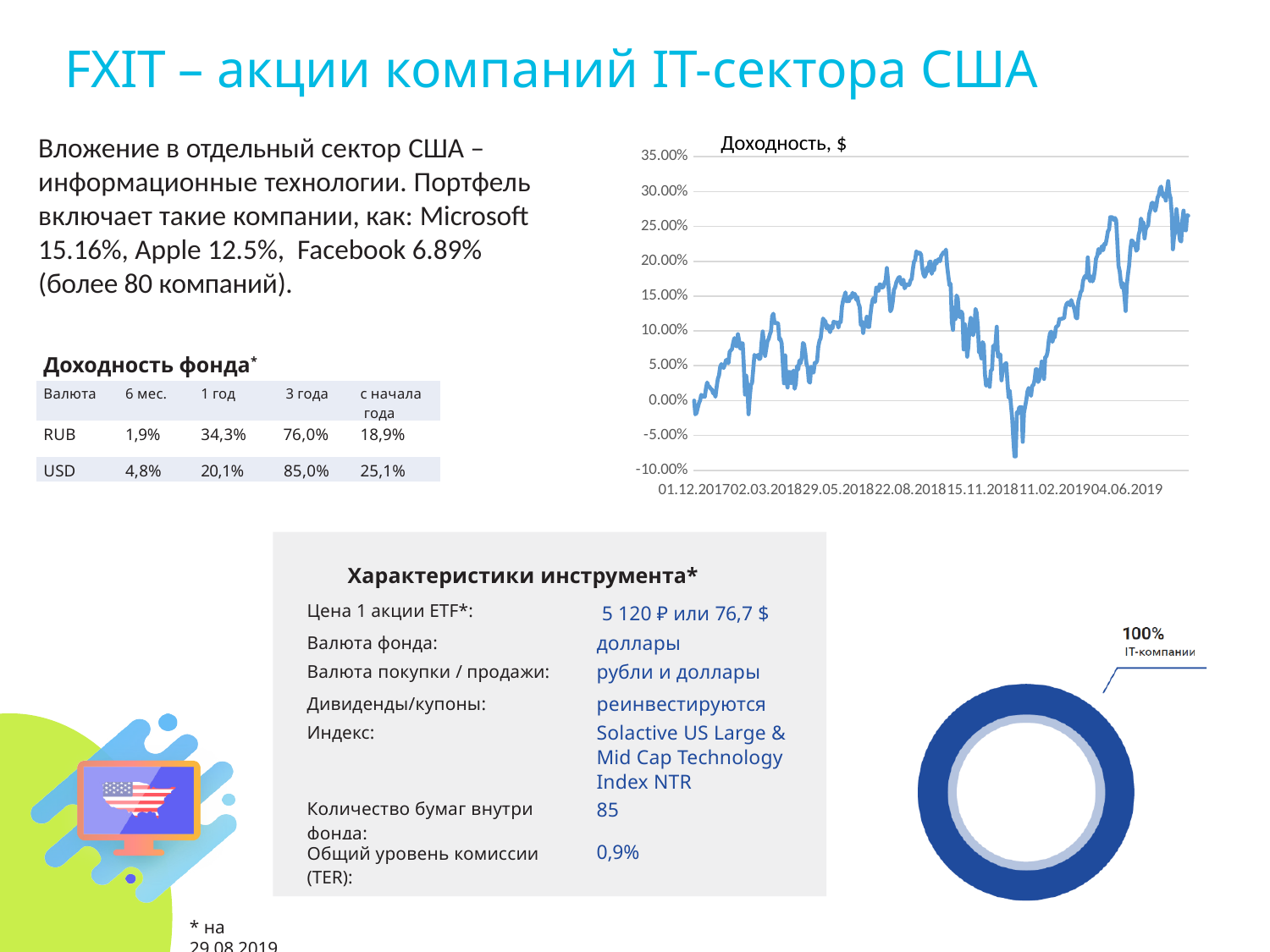
On the "Доходность, $" chart, what is the lowest value shown on the vertical axis? -10.00% On the "Доходность, $" chart, how many date labels are shown on the horizontal axis? 7 On the "Доходность, $" chart, what is the last date label on the horizontal axis? 04.06.2019 On the "Доходность, $" chart, does the line overall rise or fall from the start to the end of the period? rise On the "Доходность, $" chart, what is the highest value shown on the vertical axis? 35.00% On the "Доходность, $" chart, what is the first date label on the horizontal axis? 01.12.2017 What kind of chart is the chart titled "Доходность, $"? line chart On the "Доходность, $" chart, is the lowest point of the line greater or less than -5.00%? less What kind of chart is shown in the lower right of the slide? donut chart In the donut chart in the lower right, what share is labelled for IT-компании? 100% What is the title of the chart in the upper right of the slide? Доходность, $